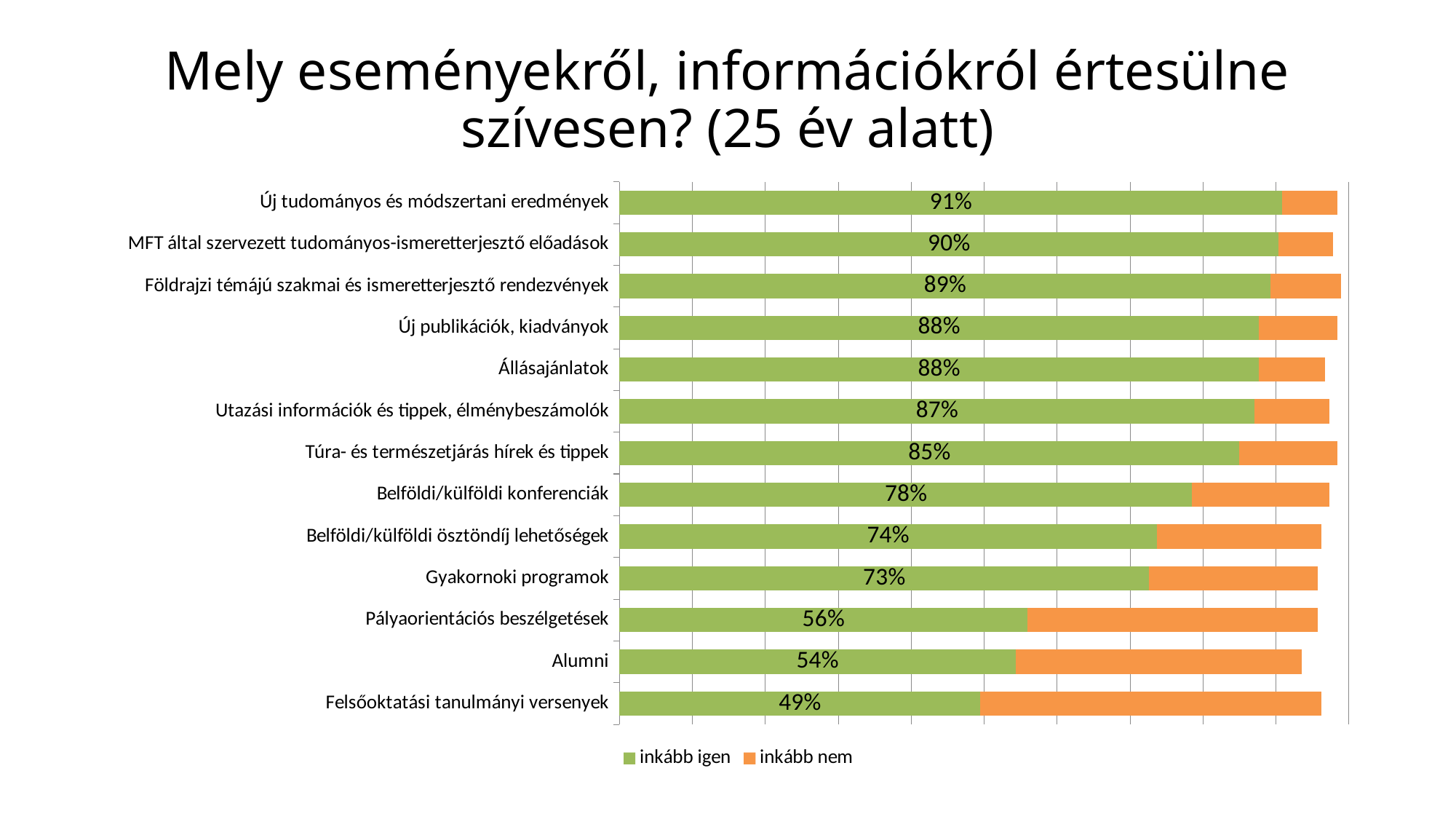
How many categories are shown in the chart? 13 What is the "inkább igen" value for Új tudományos és módszertani eredmények? 91% What is the "inkább igen" value for Gyakornoki programok? 73% Which category has the lowest "inkább igen" value? Felsőoktatási tanulmányi versenyek What is the difference between the "inkább igen" values for Belföldi/külföldi konferenciák and Pályaorientációs beszélgetések? 22% Which series is shown in orange in the legend? inkább nem What is the "inkább igen" value for Alumni? 54% What is the "inkább igen" value for Túra- és természetjárás hírek és tippek? 85% How many series does the legend list? 2 Which has a larger "inkább igen" value: Állásajánlatok or Belföldi/külföldi ösztöndíj lehetőségek? Állásajánlatok Which category has the highest "inkább igen" value? Új tudományos és módszertani eredmények What kind of chart is shown on the slide? Stacked bar chart